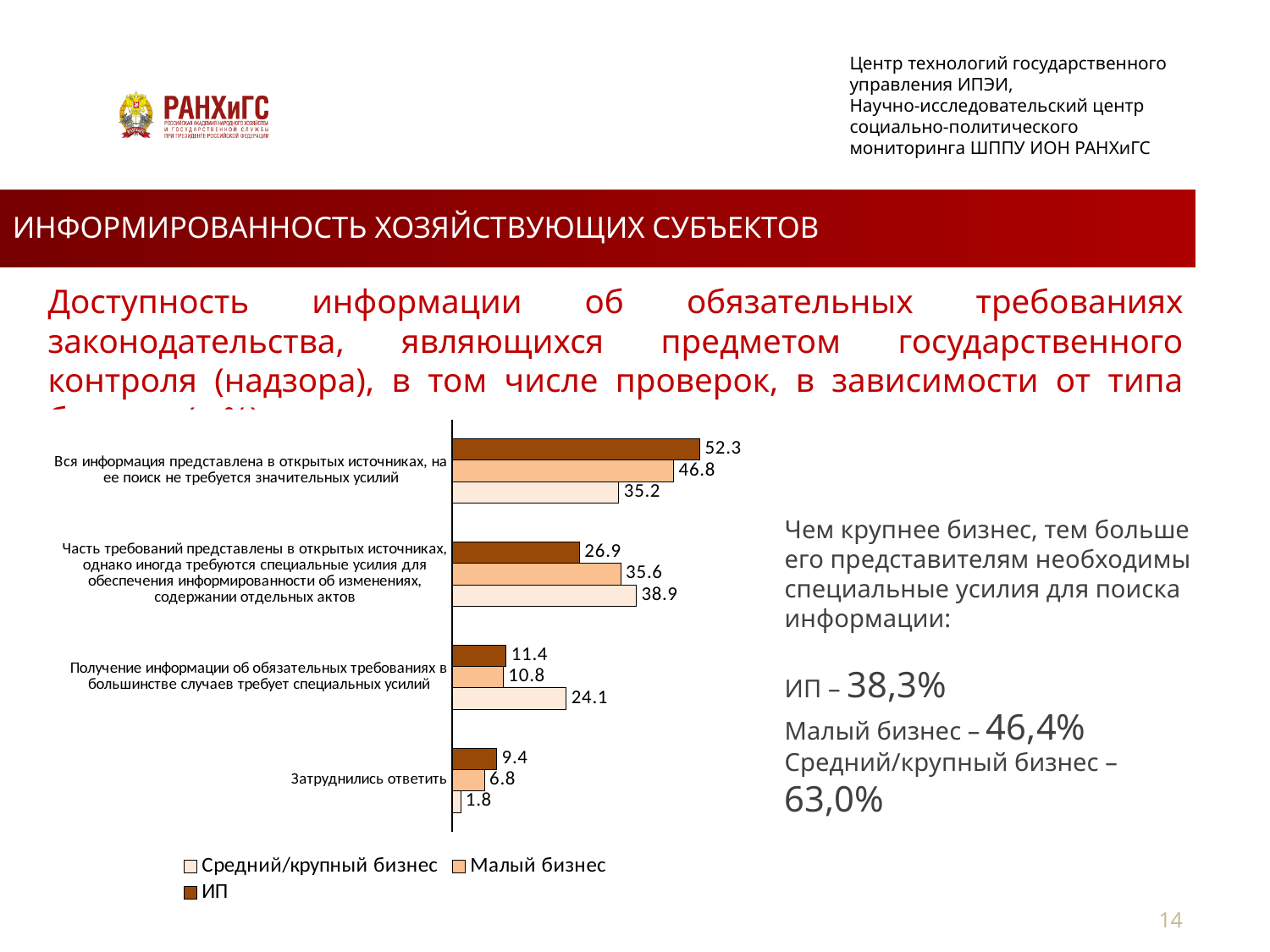
What type of chart is shown on the slide? bar chart What is the difference between the ИП and Средний/крупный бизнес values in the category "Вся информация представлена в открытых источниках, на ее поиск не требуется значительных усилий"? 17.1 Which series has the lowest value in the category "Затруднились ответить"? Средний/крупный бизнес What is the value for ИП in the category "Вся информация представлена в открытых источниках, на ее поиск не требуется значительных усилий"? 52.3 Which series has the highest value in the category "Часть требований представлены в открытых источниках, однако иногда требуются специальные усилия для обеспечения информированности об изменениях, содержании отдельных актов"? Средний/крупный бизнес What is the value for Малый бизнес in the category "Затруднились ответить"? 6.8 What is the value for Средний/крупный бизнес in the category "Получение информации об обязательных требованиях в большинстве случаев требует специальных усилий"? 24.1 How many series does the chart legend list? 3 In the category "Получение информации об обязательных требованиях в большинстве случаев требует специальных усилий", which is larger: the value for ИП or for Малый бизнес? ИП How many categories are shown on the chart? 4 Which category has the highest value for Малый бизнес? Вся информация представлена в открытых источниках, на ее поиск не требуется значительных усилий Which series is shown with the darkest brown bars in the chart? ИП